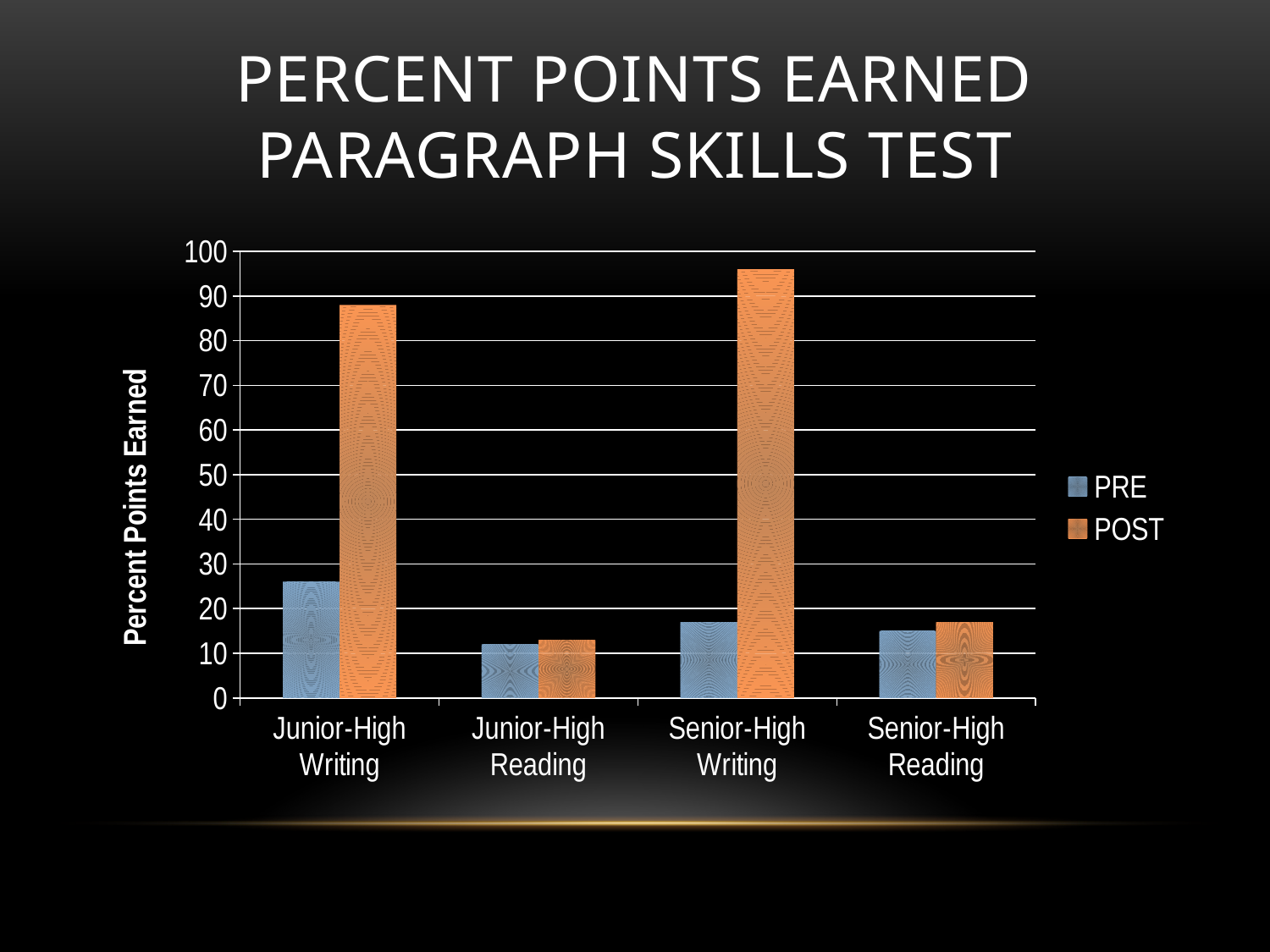
What kind of chart is shown on the slide? bar chart Is the PRE value for Junior-High Reading greater or less than 20? less Is the POST value for Senior-High Writing greater or less than 90? greater Is the POST value for Junior-High Writing greater or less than 80? greater Which category has the highest POST value? Senior-High Writing Which category has the lowest POST value? Junior-High Reading Which is larger for Junior-High Writing, the PRE value or the POST value? POST How many series does the legend list? 2 How many categories are shown on the x axis? 4 Which category has the highest PRE value? Junior-High Writing What is the label on the vertical axis? Percent Points Earned